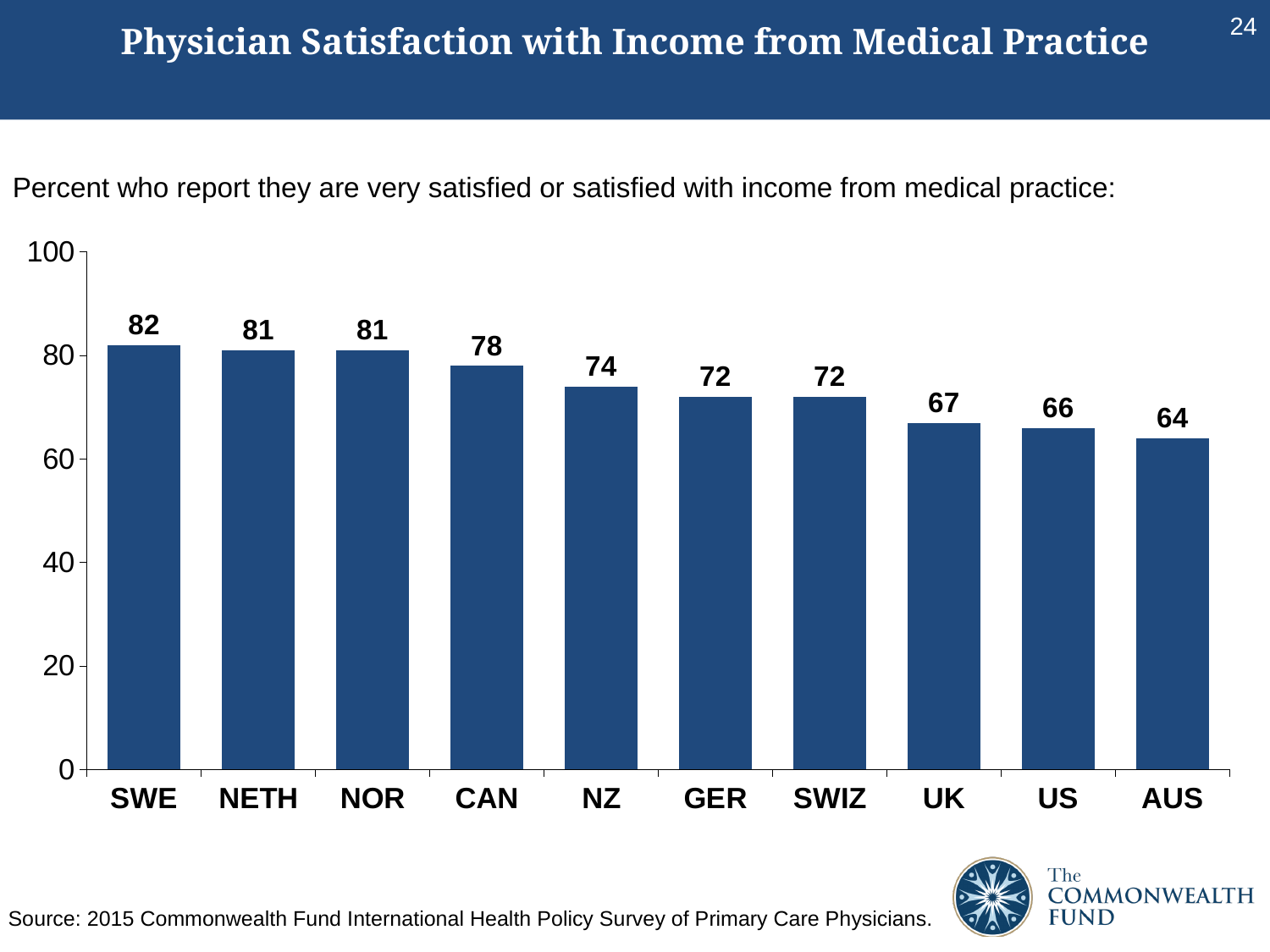
How many countries are shown in the chart? 10 What is the value for SWE? 82 What kind of chart is shown on the slide? bar chart Which country has the highest value? SWE What is the difference between the values for NZ and US? 8 What is the value for UK? 67 What is the difference between the values for SWE and AUS? 18 Which country has the lowest value? AUS What is the value for CAN? 78 Do the values rise or fall from left to right along the x axis? fall Is the value for US greater or less than 60? greater Which is larger, the value for CAN or the value for GER? CAN